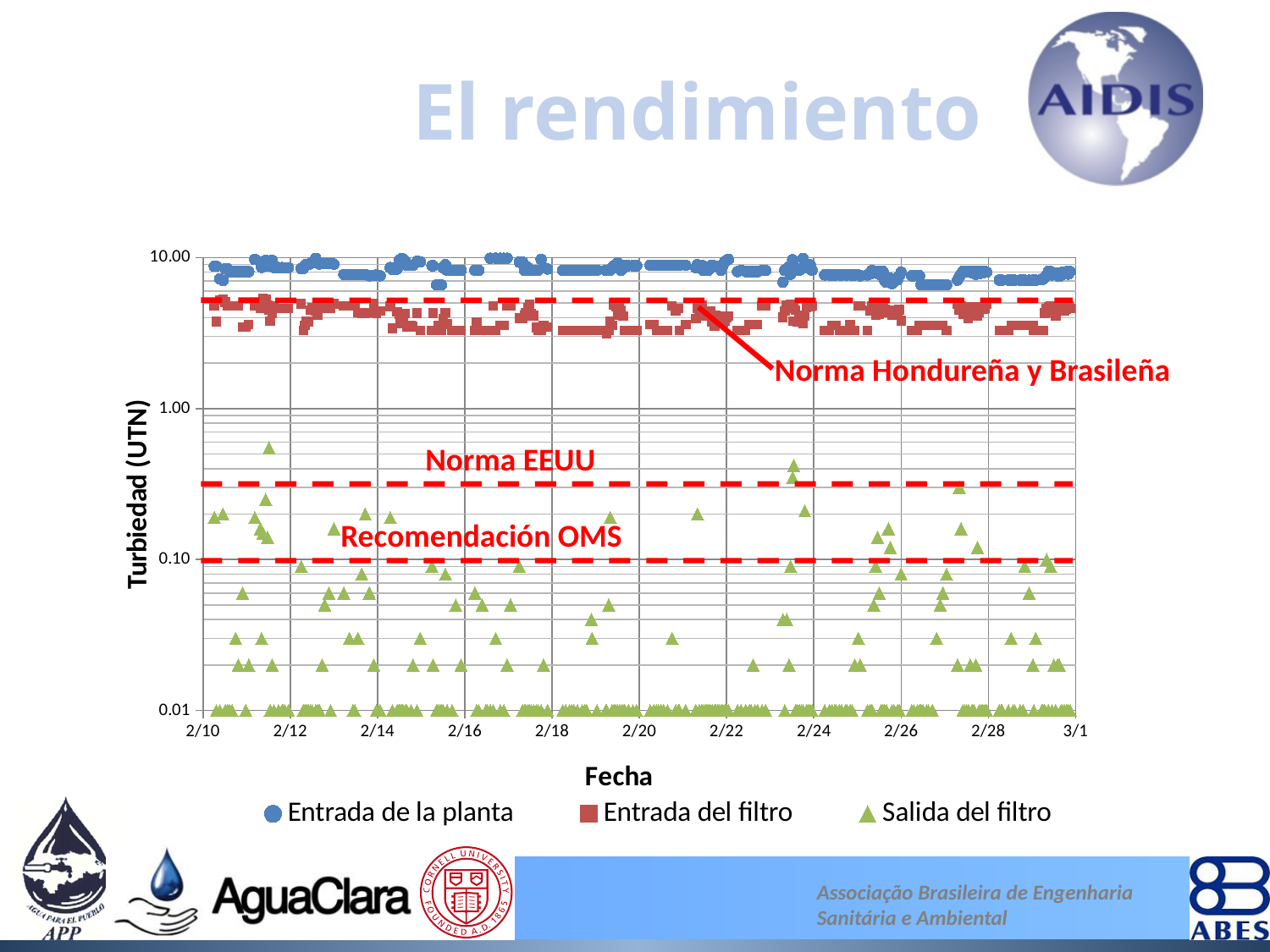
What kind of chart is shown on the slide? scatter chart What is the label of the y axis of the chart? Turbiedad (UTN) Are the values for Salida del filtro greater or less than 1.00 UTN? less Which series has the highest turbidity values throughout the chart? Entrada de la planta Which series has higher values, Entrada de la planta or Entrada del filtro? Entrada de la planta Are the values for Entrada del filtro greater or less than 1.00 UTN? greater Are the values for Entrada de la planta greater or less than 1.00 UTN? greater How many series does the chart legend list? 3 Which series has the lowest turbidity values throughout the chart? Salida del filtro Which dashed reference line on the chart is the lowest: Norma Hondureña y Brasileña, Norma EEUU, or Recomendación OMS? Recomendación OMS What is the label of the x axis of the chart? Fecha Which series has higher values, Entrada del filtro or Salida del filtro? Entrada del filtro